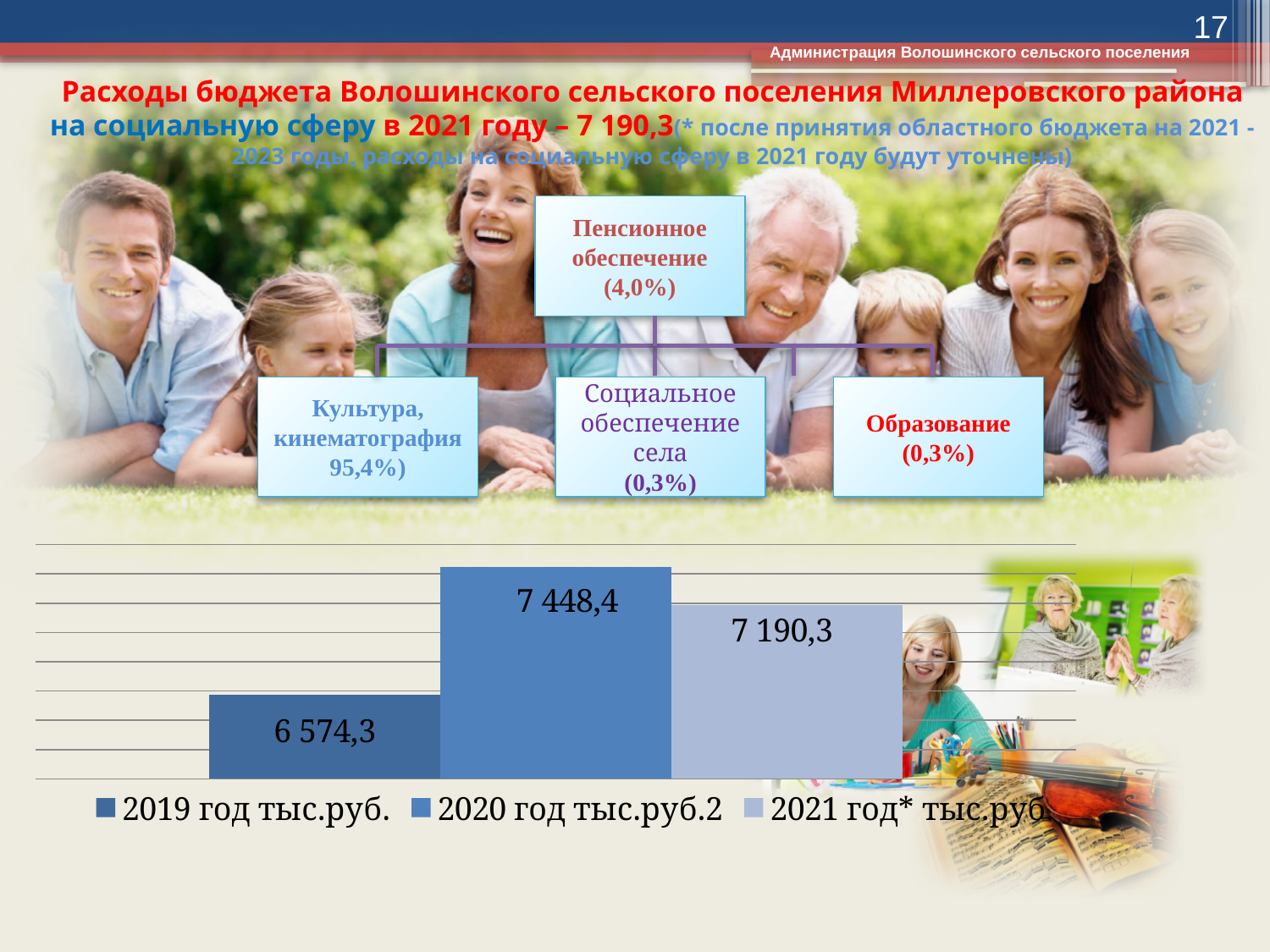
How many bars are plotted in the bar chart? 3 Which is larger in the bar chart, the value for 2021 год* or the value for 2019 год? 2021 год* What type of chart is shown at the bottom of the slide? bar chart What is the value for 2020 год in the bar chart? 7 448,4 What is the value for 2019 год in the bar chart? 6 574,3 What is the difference between the 2020 год and 2019 год values in the bar chart? 874,1 Which year has the highest value in the bar chart? 2020 год What is the value for 2021 год* in the bar chart? 7 190,3 What is the difference between the 2020 год and 2021 год* values in the bar chart? 258,1 In the diagram above the bar chart, what share is shown for Культура, кинематография? 95,4% Which year has the lowest value in the bar chart? 2019 год How many series does the legend of the bar chart list? 3